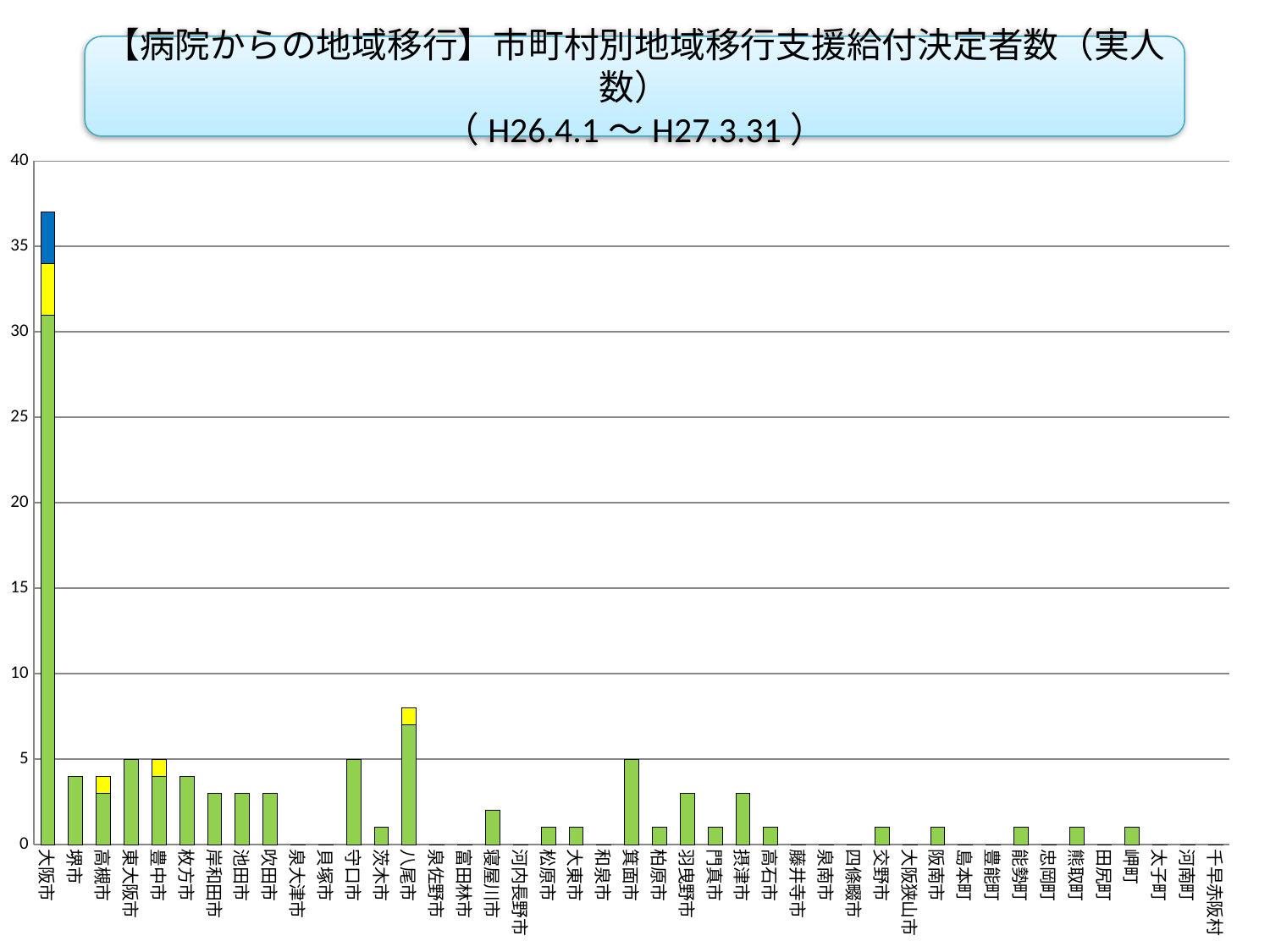
What kind of chart is shown on the slide? bar chart Which is larger, the bar for 大阪市 or the bar for 堺市? 大阪市 What is the total value of the bar for 守口市? 5 Is the value for 大阪市 greater or less than 35? greater Which municipality has the highest bar? 大阪市 What is the highest value shown on the vertical axis? 40 Is the value for 寝屋川市 greater or less than 5? less What is the total value of the bar for 東大阪市? 5 Is the value for 堺市 greater or less than 5? less What is the total value of the stacked bar for 豊中市? 5 Which is larger, the bar for 八尾市 or the bar for 守口市? 八尾市